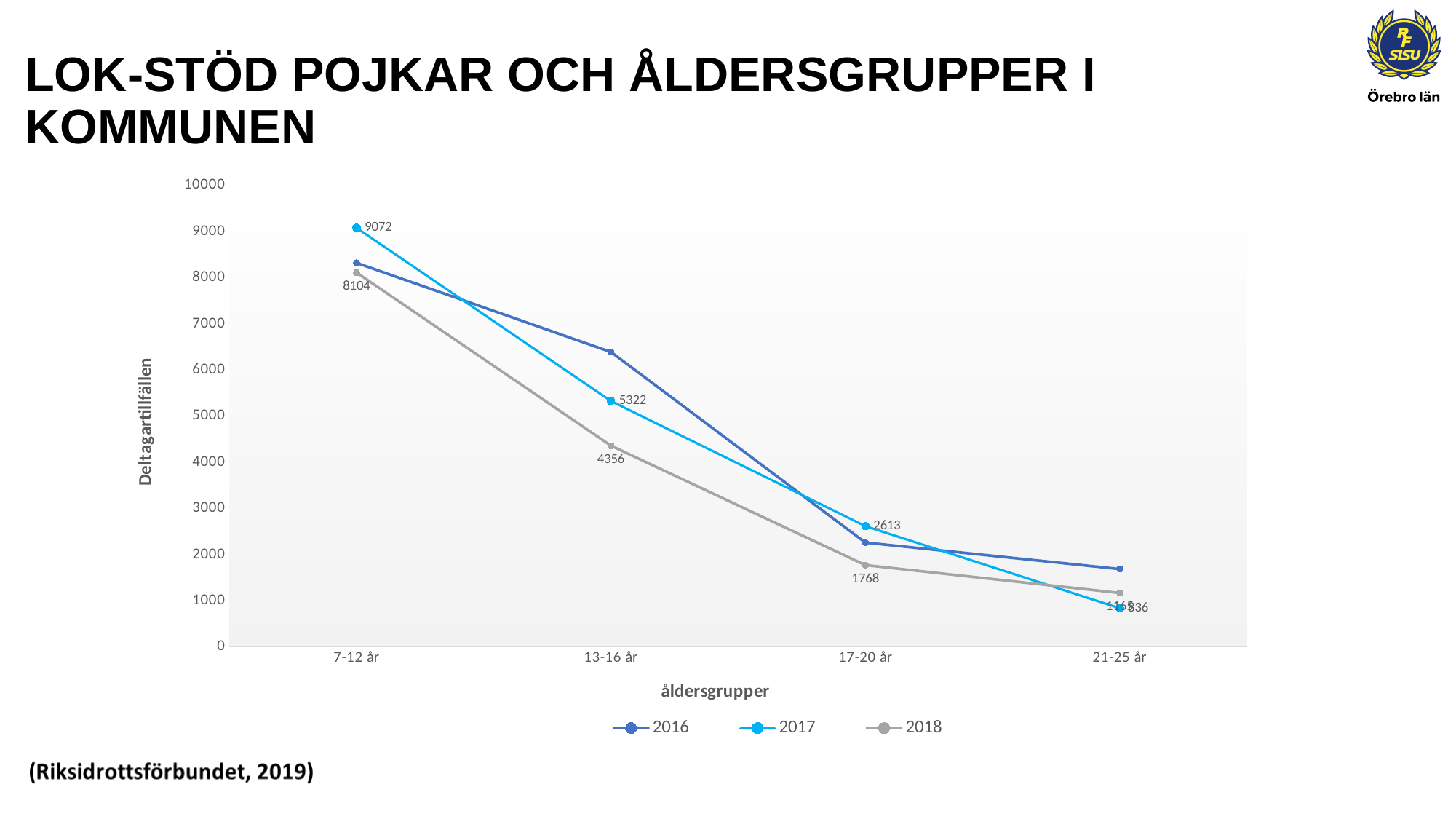
Do the values for the 2018 series rise or fall as the age groups increase along the x axis? fall How many series does the legend list? 3 Is the value for 2016 in the 13-16 år age group greater or less than 6000? greater What is the value for 2017 in the 7-12 år age group? 9072 How many age groups are shown on the x axis? 4 What is the value for 2018 in the 13-16 år age group? 4356 What is the value for 2017 in the 17-20 år age group? 2613 What is the value for 2018 in the 17-20 år age group? 1768 For the 2017 series, which age group has the highest value? 7-12 år What is the difference between the 2017 and 2018 values for the 7-12 år age group? 968 Which series has the higher value in the 17-20 år age group, 2017 or 2018? 2017 What kind of chart is shown on the slide? line chart